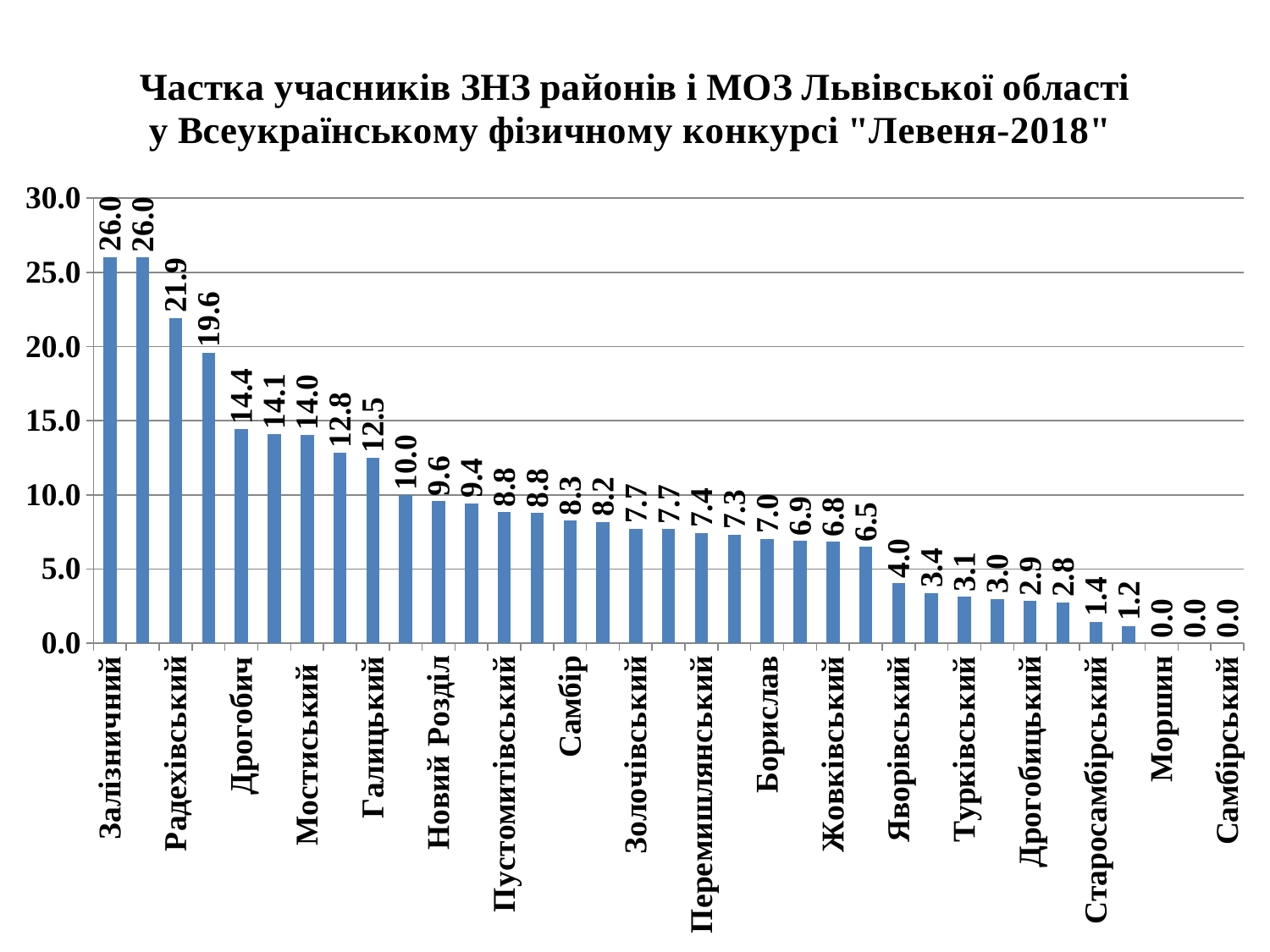
What kind of chart is shown on the slide? bar chart What is the value for Яворівський? 4.0 What is the value for Залізничний? 26.0 Which has a larger value, Мостиський or Борислав? Мостиський What is the value for Самбірський? 0.0 What is the value for Радехівський? 21.9 What is the value for Дрогобич? 14.4 What is the value for Галицький? 12.5 Is the value for Новий Розділ greater or less than 10.0? less What is the value for Старосамбірський? 1.4 Do the values rise or fall from left to right along the x axis? fall What is the difference between the values for Залізничний and Радехівський? 4.1